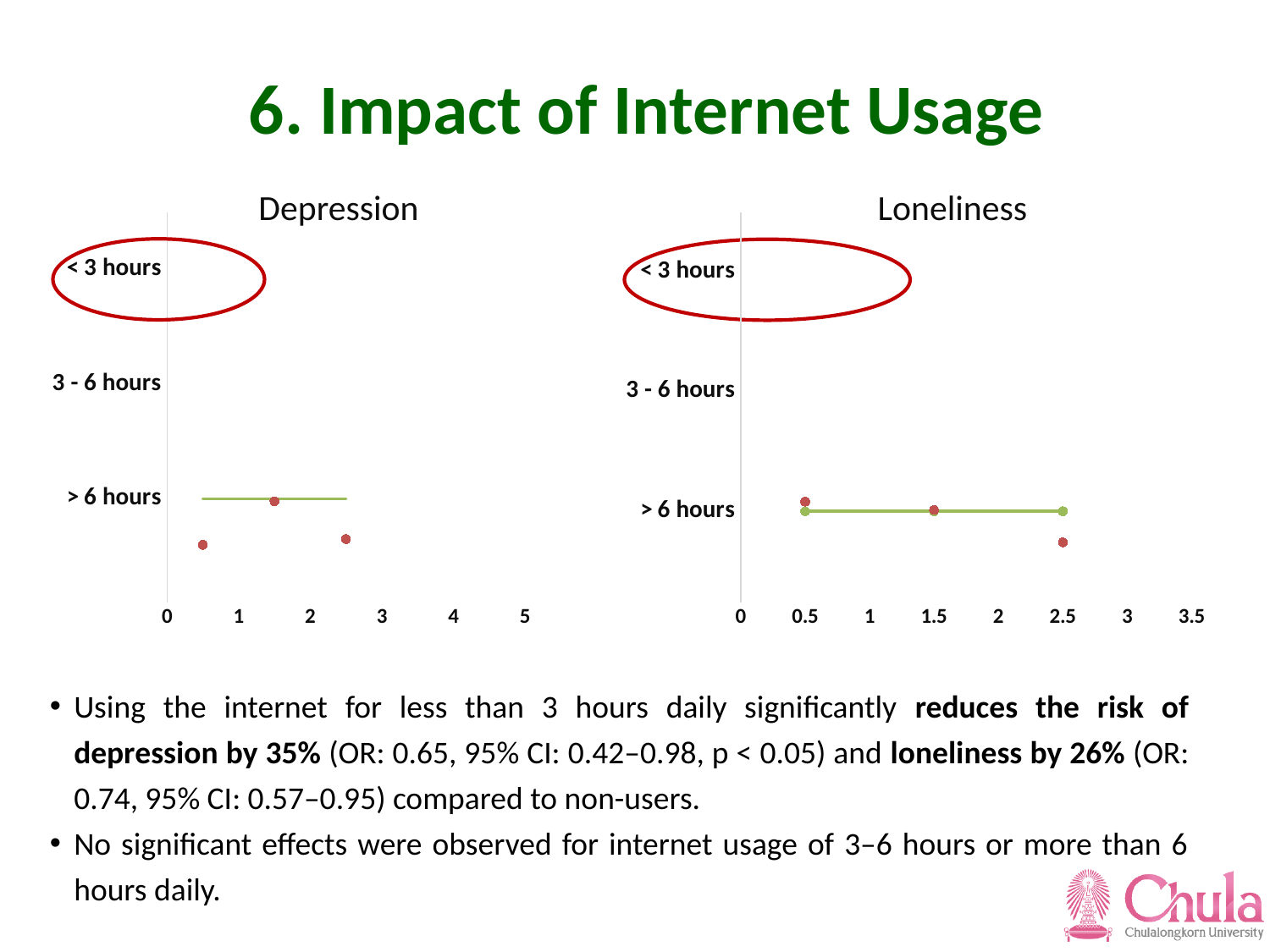
What is the title of the chart on the left? Depression What is the title of the chart on the right? Loneliness In the Depression chart, which category has plotted data points? > 6 hours In the Loneliness chart, is the rightmost plotted point for > 6 hours greater or less than 2? greater In the Depression chart, how many categories are listed on the vertical axis? 3 In the Loneliness chart, how many categories are listed on the vertical axis? 3 In the Loneliness chart, what is the highest value shown on the horizontal axis? 3.5 In the Loneliness chart, which category has plotted data points? > 6 hours In the Loneliness chart, is the leftmost plotted point for > 6 hours greater or less than 1? less In the Depression chart, what is the highest value shown on the horizontal axis? 5 In the Depression chart, is the leftmost plotted point for > 6 hours greater or less than 1? less